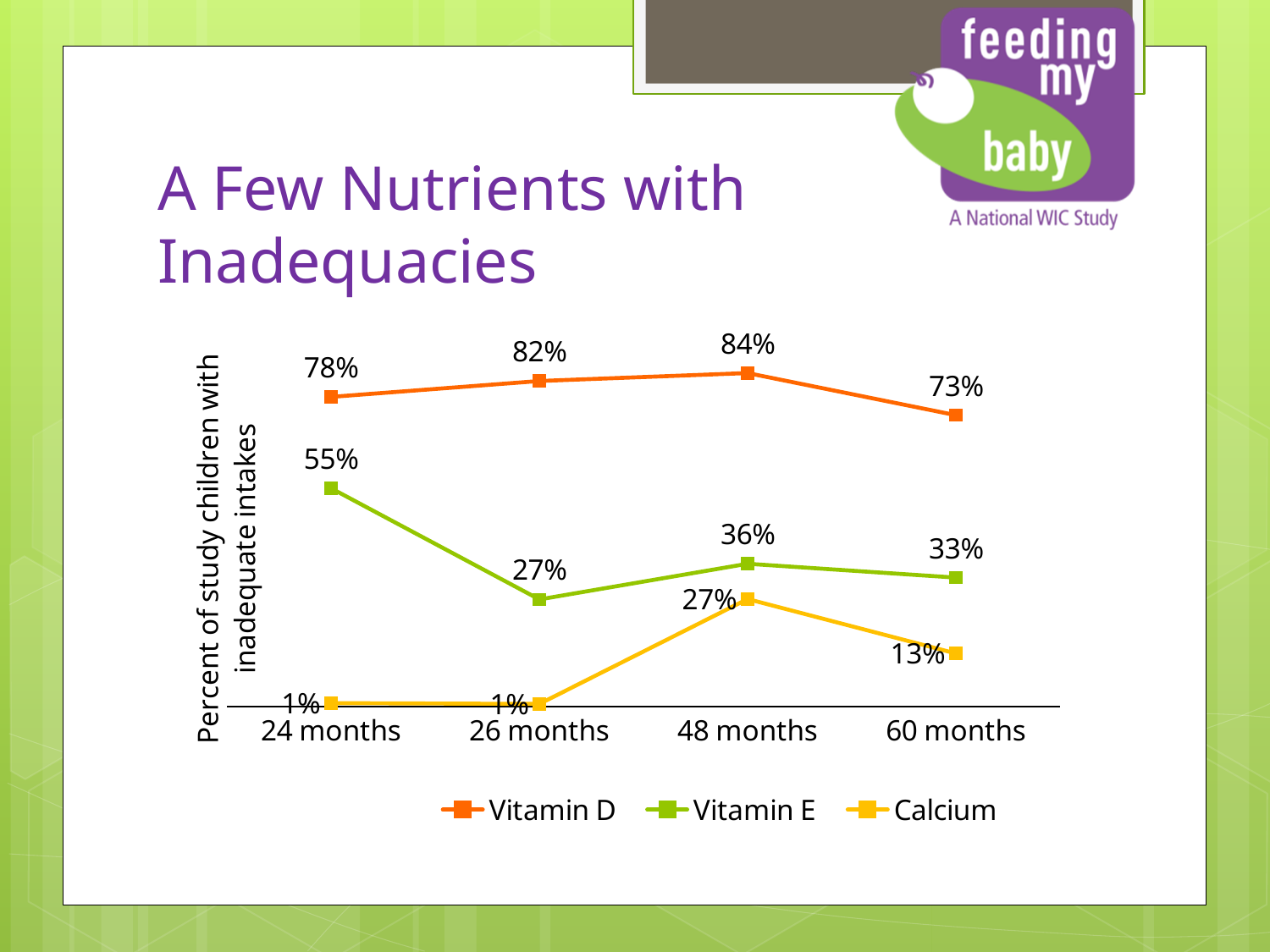
Which is larger at 48 months, the Vitamin E value or the Calcium value? Vitamin E What is the difference between the Vitamin D and Vitamin E values at 60 months? 40% What is the Vitamin D value at 48 months? 84% Does the Vitamin E value rise or fall from 24 months to 26 months? Fall What is the Calcium value at 60 months? 13% How many series does the legend list? 3 What is the label of the y axis? Percent of study children with inadequate intakes What kind of chart is shown on the slide? Line chart At which age is the Vitamin E value lowest? 26 months What is the Vitamin E value at 24 months? 55% At which age is the Vitamin D value highest? 48 months How many age points are shown on the x axis? 4